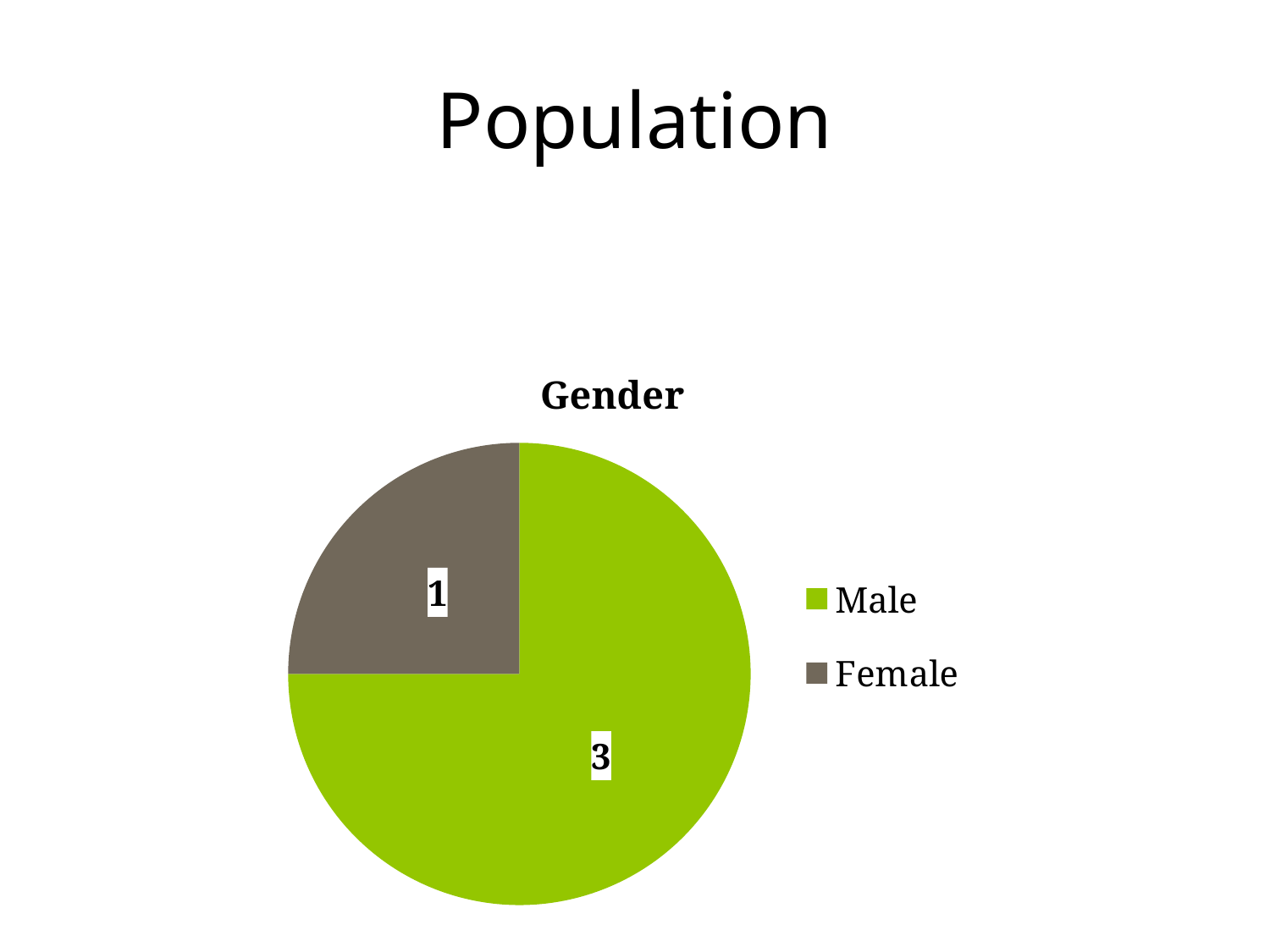
What is the difference between the Male and Female values in the Gender pie chart? 2 Which category has the smallest slice in the Gender pie chart? Female What is the value for Male in the Gender pie chart? 3 What kind of chart is shown on the slide? Pie chart How many categories are shown in the Gender pie chart? 2 Which category has the largest slice in the Gender pie chart? Male Which is larger in the Gender pie chart, Male or Female? Male What is the value for Female in the Gender pie chart? 1 What share of the Gender pie chart does the Female slice represent? 25% What share of the Gender pie chart does the Male slice represent? 75% What is the title of the pie chart? Gender What is the total of all slices in the Gender pie chart? 4